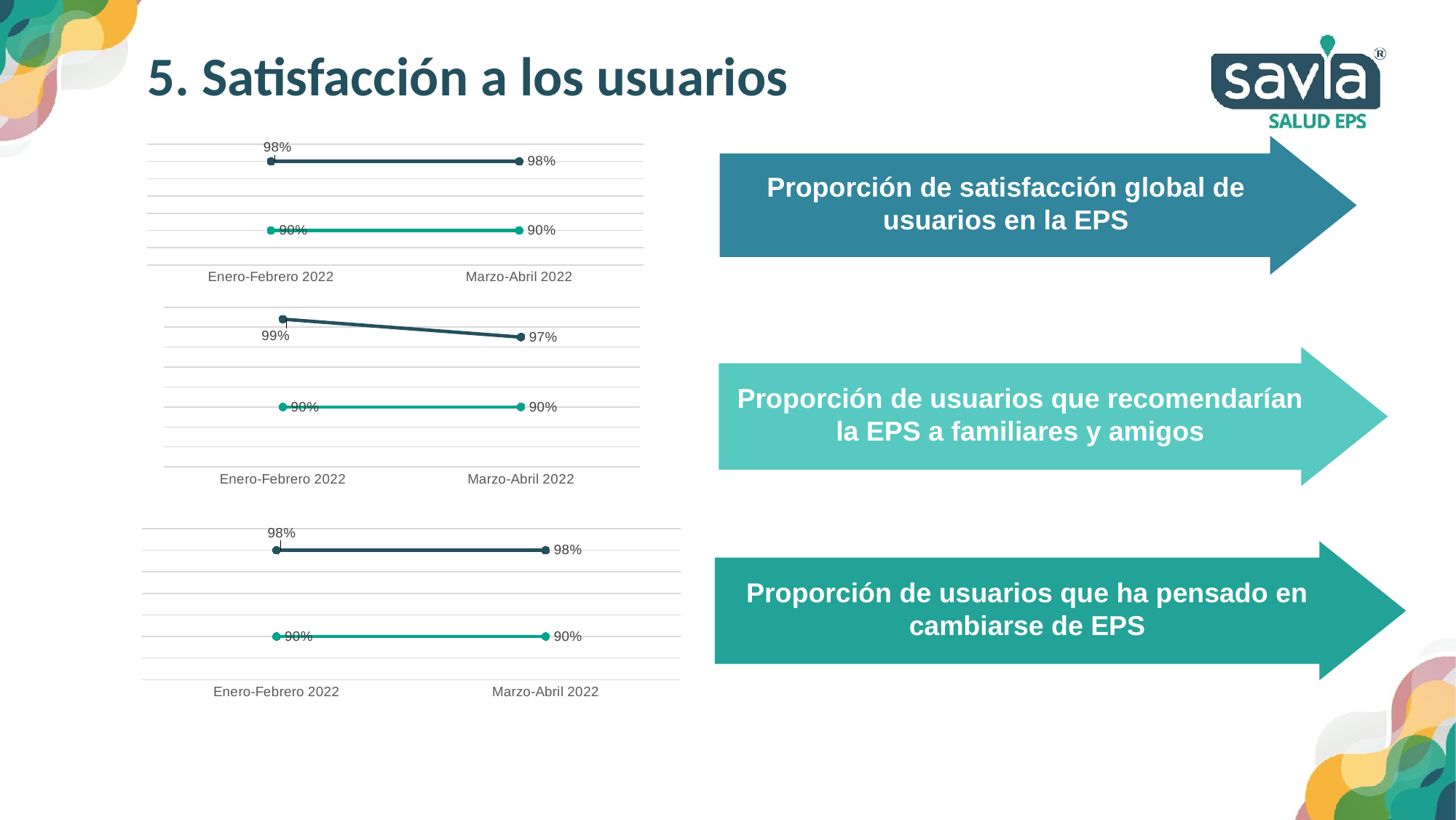
In the top chart, what is the value of the dark line for Marzo-Abril 2022? 98% In the middle chart, which period has the higher value on the dark line, Enero-Febrero 2022 or Marzo-Abril 2022? Enero-Febrero 2022 In the middle chart, what is the value of the dark line for Marzo-Abril 2022? 97% In the middle chart, does the dark line rise or fall from Enero-Febrero 2022 to Marzo-Abril 2022? fall In the middle chart, by how much does the dark line drop from Enero-Febrero 2022 to Marzo-Abril 2022? 2 percentage points In the top chart, does the dark line rise, fall or stay the same from Enero-Febrero 2022 to Marzo-Abril 2022? stay the same In the middle chart, what is the value of the dark line for Enero-Febrero 2022? 99% In the top chart, what is the value of the dark line for Enero-Febrero 2022? 98% How many categories are shown on the x axis of the top chart? 2 In the bottom chart, what is the value of the dark line for Marzo-Abril 2022? 98% In the bottom chart, what is the value of the green line for Marzo-Abril 2022? 90% What kind of chart is the middle chart? line chart